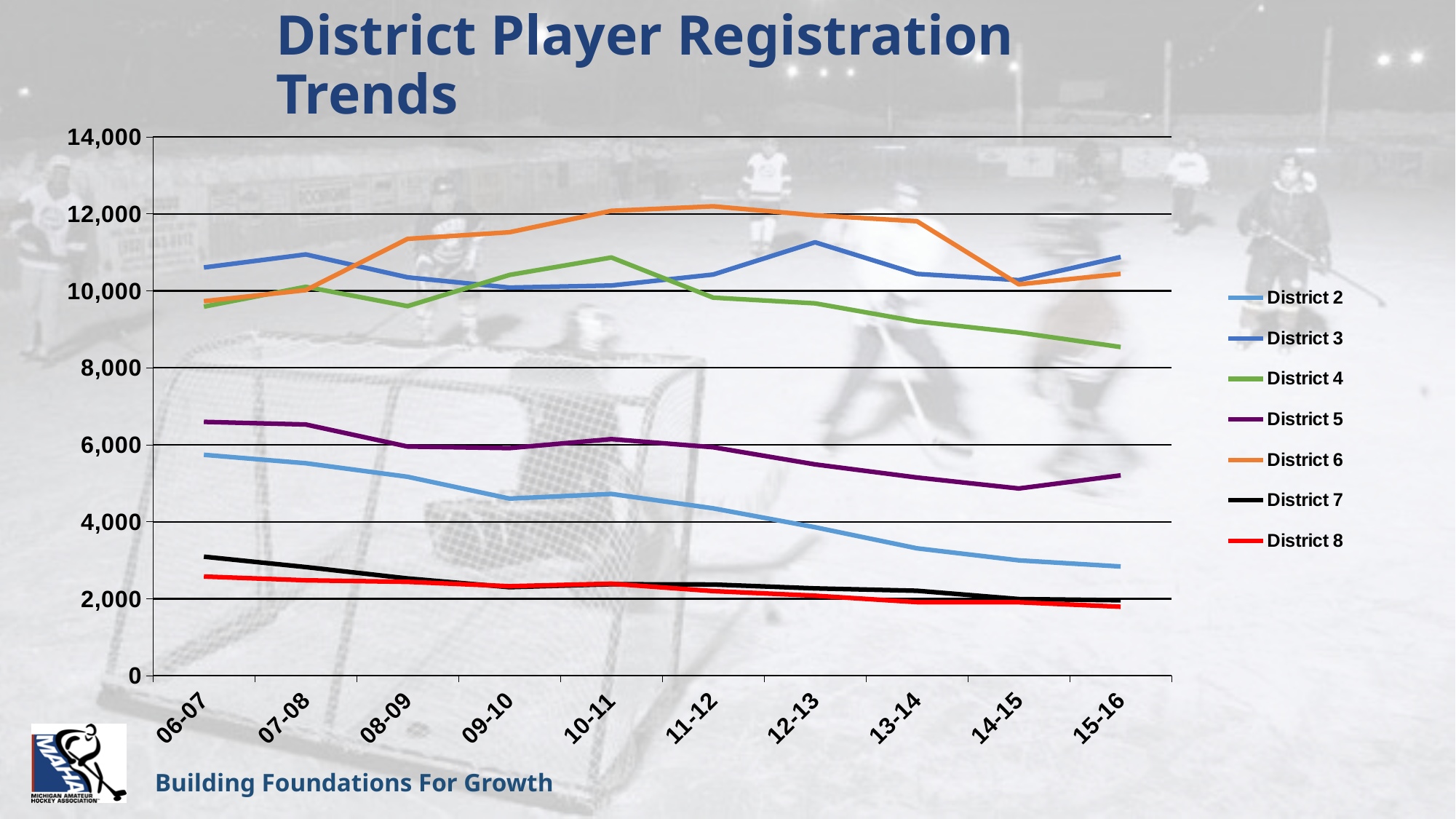
What kind of chart is shown on the slide? line chart Which district had the lowest registration in 06-07? District 8 How many seasons are shown along the x axis? 10 Does the District 2 line rise or fall from 06-07 to 15-16? fall Which is larger in 15-16, District 3 or District 4? District 3 Which district had the highest registration in 11-12? District 6 Is the value for District 2 in 15-16 greater or less than 4,000? less How many series does the legend list? 7 Is the value for District 6 in 14-15 greater or less than 12,000? less What is the title of the chart? District Player Registration Trends Is the value for District 5 in 06-07 greater or less than 6,000? greater Which district had the highest registration in 06-07? District 3